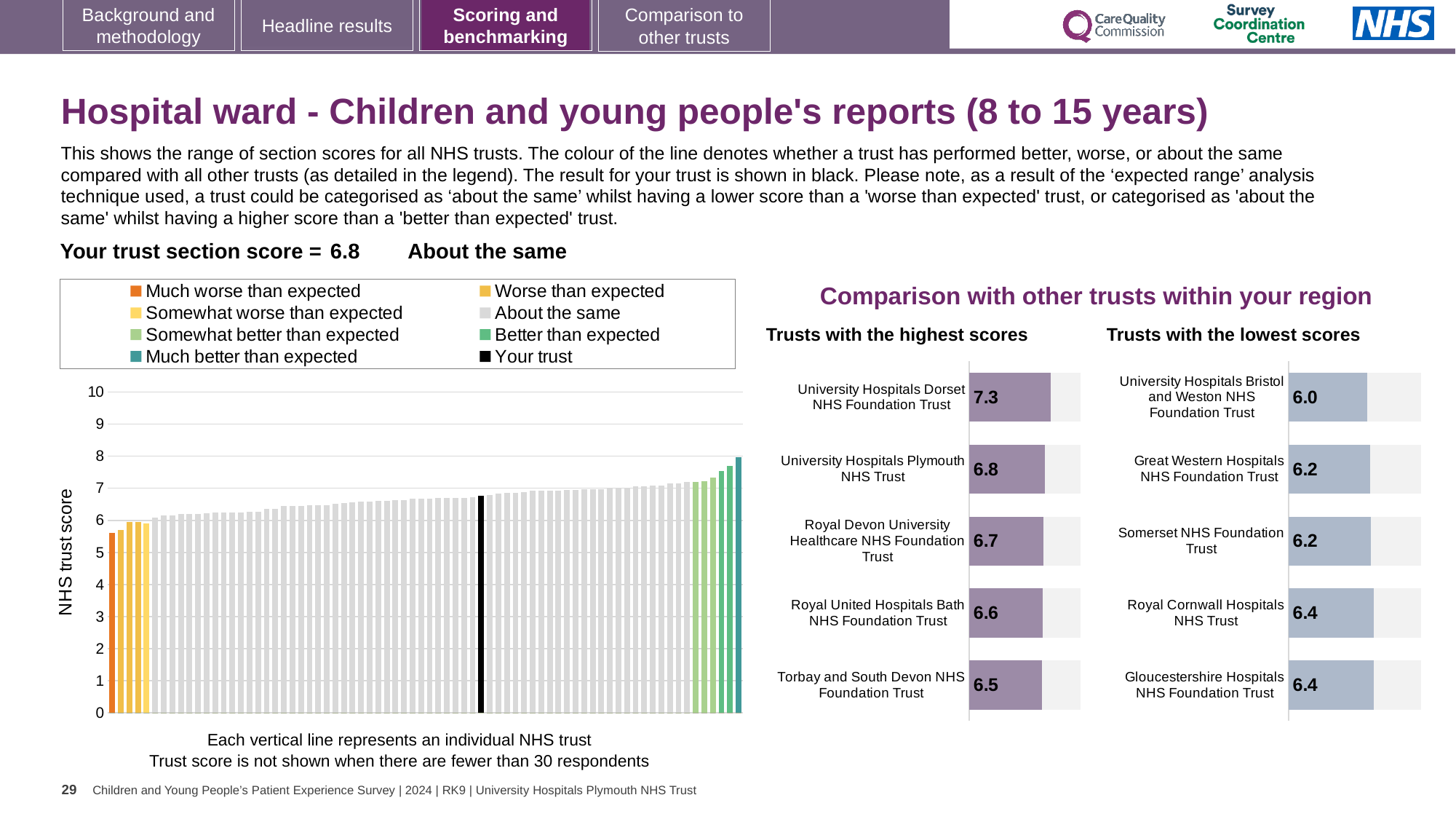
In the 'Trusts with the highest scores' chart, what is the score for Torbay and South Devon NHS Foundation Trust? 6.5 In the 'Trusts with the lowest scores' chart, which has the larger score: Great Western Hospitals NHS Foundation Trust or Royal Cornwall Hospitals NHS Trust? Royal Cornwall Hospitals NHS Trust In the large chart on the left showing all NHS trusts, do the bar heights rise or fall from left to right? Rise In the 'Trusts with the lowest scores' chart, what is the score for University Hospitals Bristol and Weston NHS Foundation Trust? 6.0 In the 'Trusts with the lowest scores' chart, which trust has the lowest score? University Hospitals Bristol and Weston NHS Foundation Trust In the 'Trusts with the highest scores' chart, how many trusts are shown? 5 In the 'Trusts with the highest scores' chart, what is the score for University Hospitals Dorset NHS Foundation Trust? 7.3 In the 'Trusts with the lowest scores' chart, what is the difference between the scores of Gloucestershire Hospitals NHS Foundation Trust and University Hospitals Bristol and Weston NHS Foundation Trust? 0.4 In the 'Trusts with the highest scores' chart, what is the difference between the scores of University Hospitals Dorset NHS Foundation Trust and Torbay and South Devon NHS Foundation Trust? 0.8 In the 'Trusts with the highest scores' chart, which trust has the highest score? University Hospitals Dorset NHS Foundation Trust In the large chart on the left showing all NHS trusts, what kind of chart is it? Bar chart In the large chart on the left showing all NHS trusts, how many entries does the legend list? 8